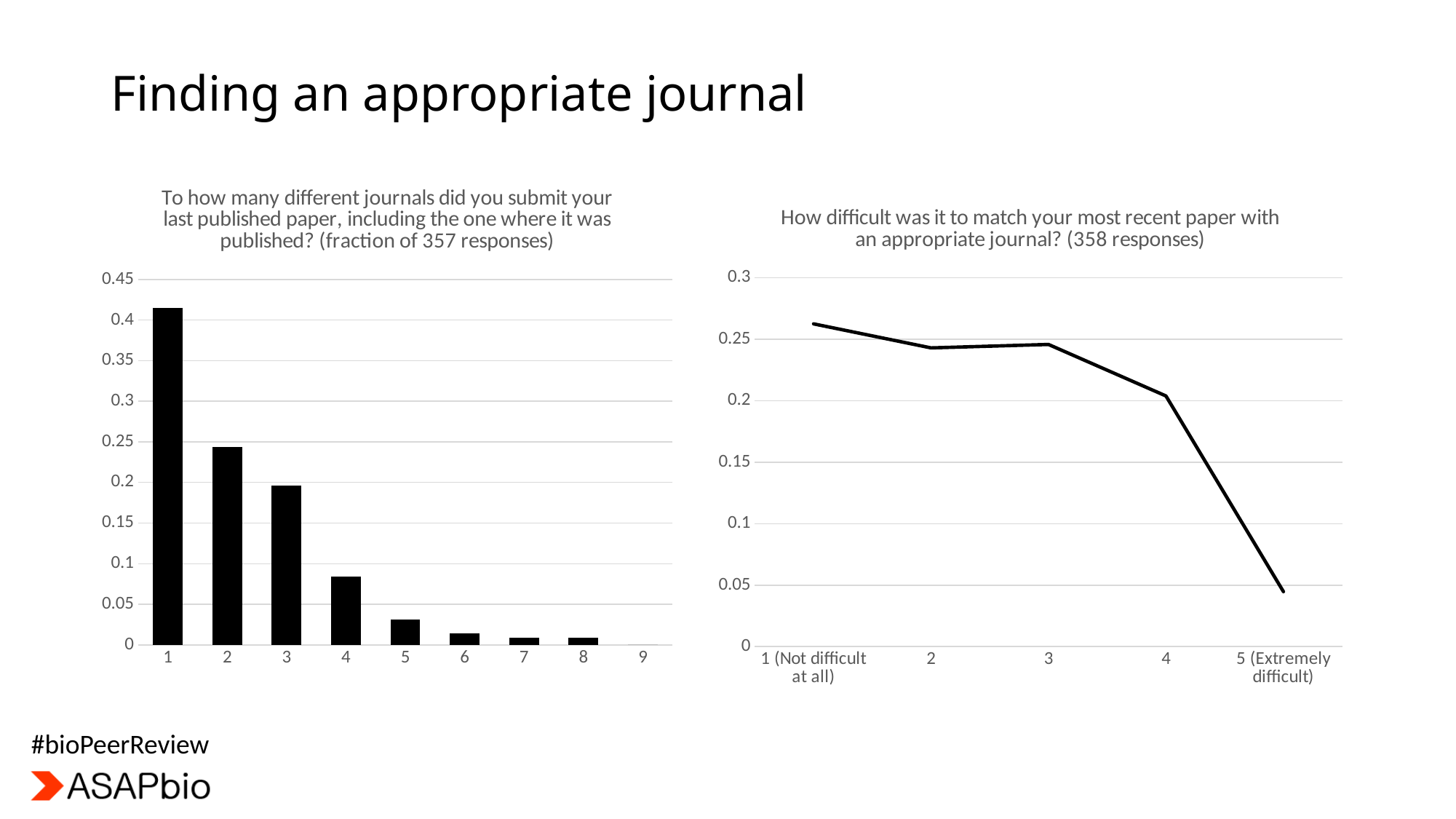
In the left chart (number of journals submitted to), which category has the lowest value? 9 What kind of chart is the right chart, titled "How difficult was it to match your most recent paper with an appropriate journal?"? line chart In the right chart (difficulty of matching a paper with a journal), is the value for "5 (Extremely difficult)" greater or less than 0.1? less In the left chart (number of journals submitted to), is the value for category 1 greater or less than 0.4? greater In the right chart (difficulty of matching a paper with a journal), how many points are plotted? 5 In the left chart (number of journals submitted to), which category has the highest value? 1 What kind of chart is the left chart, titled "To how many different journals did you submit your last published paper"? bar chart In the left chart (number of journals submitted to), is the value for category 4 greater or less than 0.1? less In the left chart (number of journals submitted to), how many categories are shown on the x axis? 9 In the left chart (number of journals submitted to), which is larger, the value for category 2 or the value for category 3? 2 In the right chart (difficulty of matching a paper with a journal), do the values generally rise or fall from category 1 to category 5? fall In the right chart (difficulty of matching a paper with a journal), which category has the lowest value? 5 (Extremely difficult)